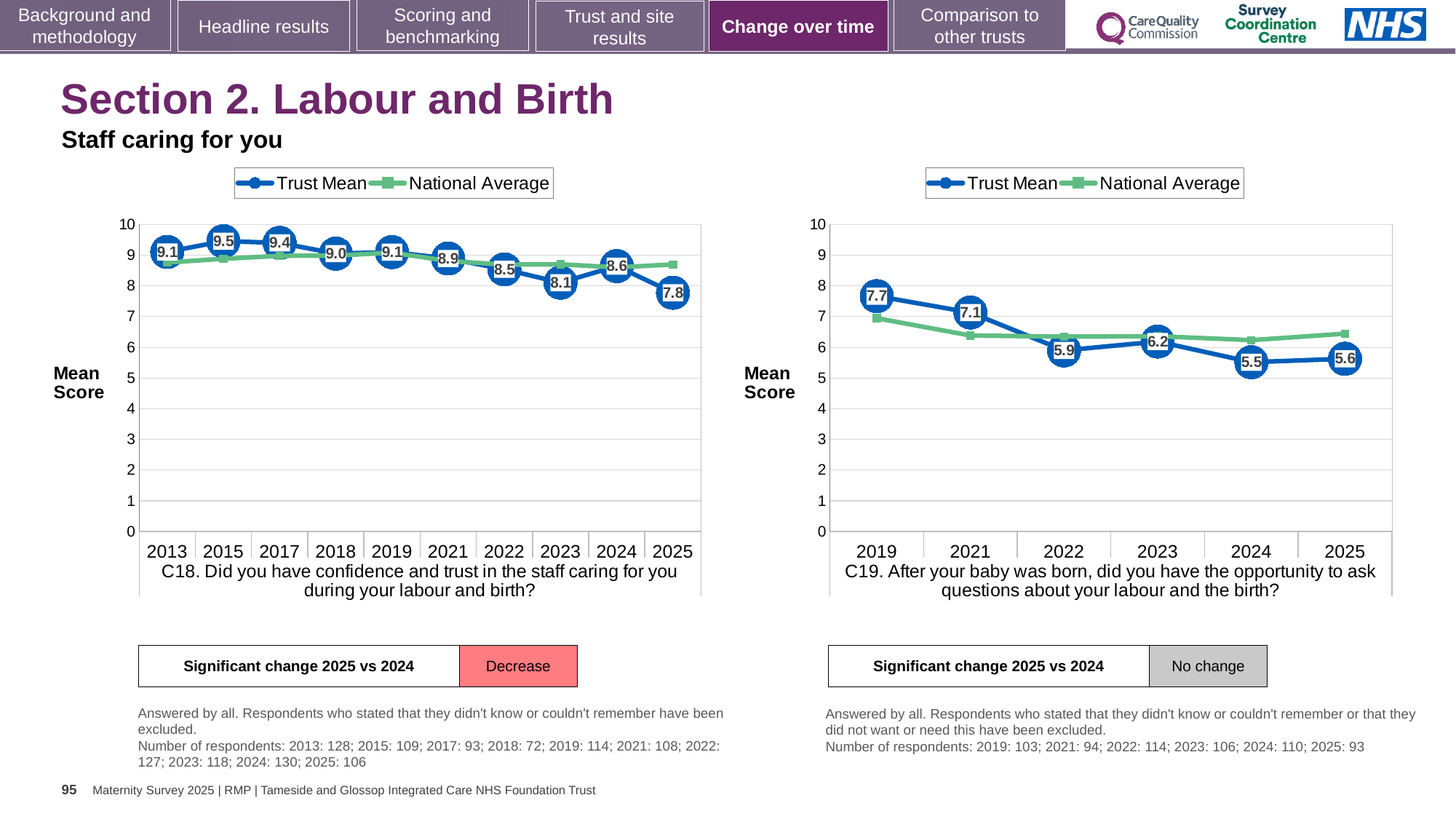
In the C18 chart on the left, what is the Trust Mean for 2015? 9.5 In the C18 chart on the left, what is the difference between the Trust Mean for 2024 and 2025? 0.8 How many years are plotted on the x axis of the C18 chart on the left? 10 In the C19 chart on the right, does the Trust Mean generally rise or fall from 2019 to 2025? Fall In the C18 chart on the left, which year has the highest Trust Mean? 2015 In the C18 chart on the left, what is the Trust Mean for 2025? 7.8 In the C19 chart on the right, what is the Trust Mean for 2019? 7.7 How many series does the legend of the C19 chart on the right list? 2 In the C19 chart on the right, which year has the lowest Trust Mean? 2024 In the C19 chart on the right, is the National Average for 2025 greater or less than 7? less What kind of chart is the C18 chart on the left? Line chart In the C19 chart on the right, which is larger, the Trust Mean for 2021 or for 2022? 2021